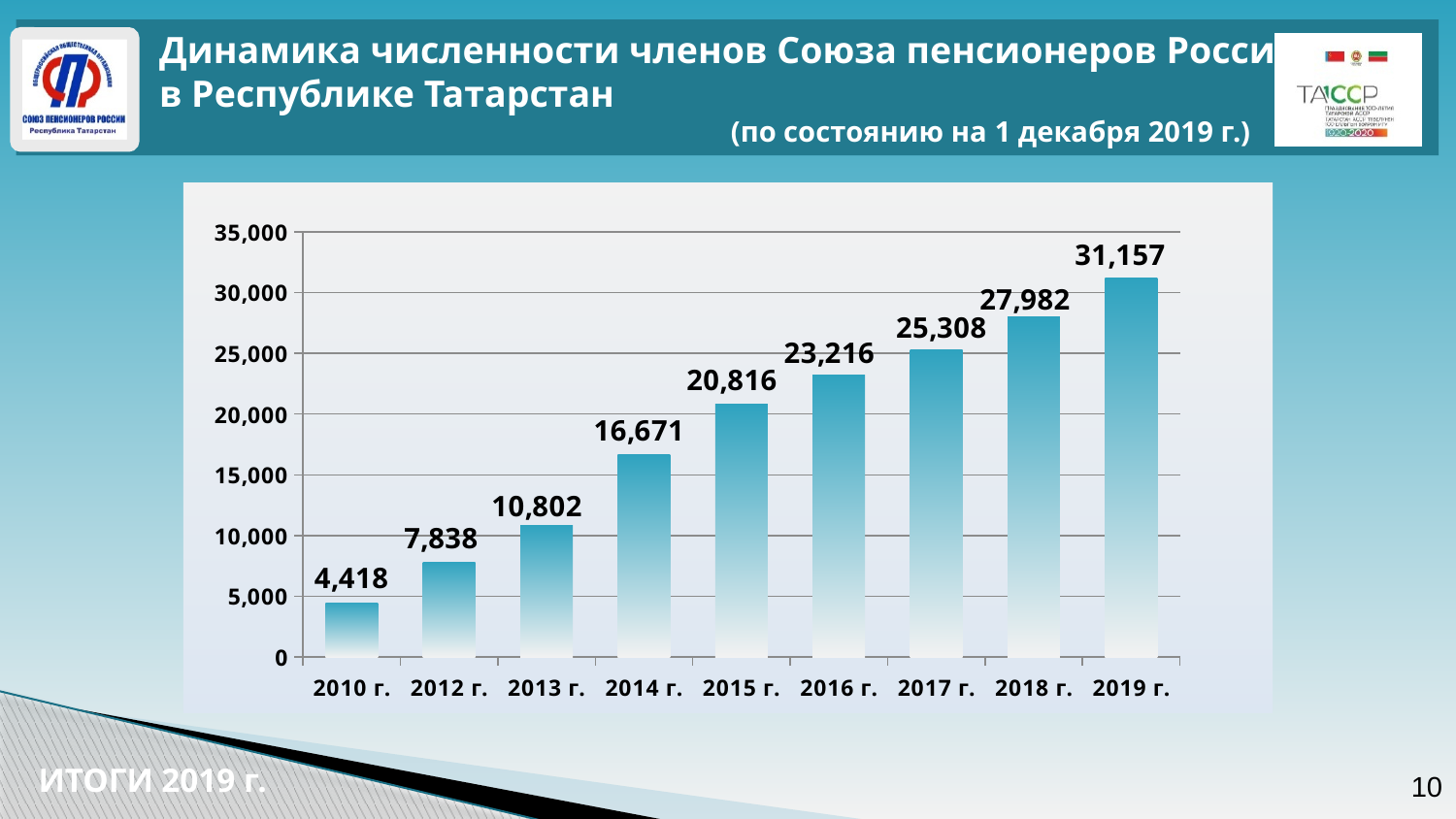
Which is larger, the value for 2016 г. or the value for 2017 г.? 2017 г. Do the values rise or fall from 2010 г. to 2019 г.? rise What kind of chart is shown on the slide? bar chart Which year has the lowest value? 2010 г. Which year has the highest value? 2019 г. How many years are shown on the x axis? 9 What is the difference between the values for 2019 г. and 2018 г.? 3,175 What is the value for 2015 г.? 20,816 What is the value for 2010 г.? 4,418 What is the value for 2019 г.? 31,157 What is the difference between the values for 2014 г. and 2013 г.? 5,869 Is the value for 2012 г. greater or less than 10,000? less